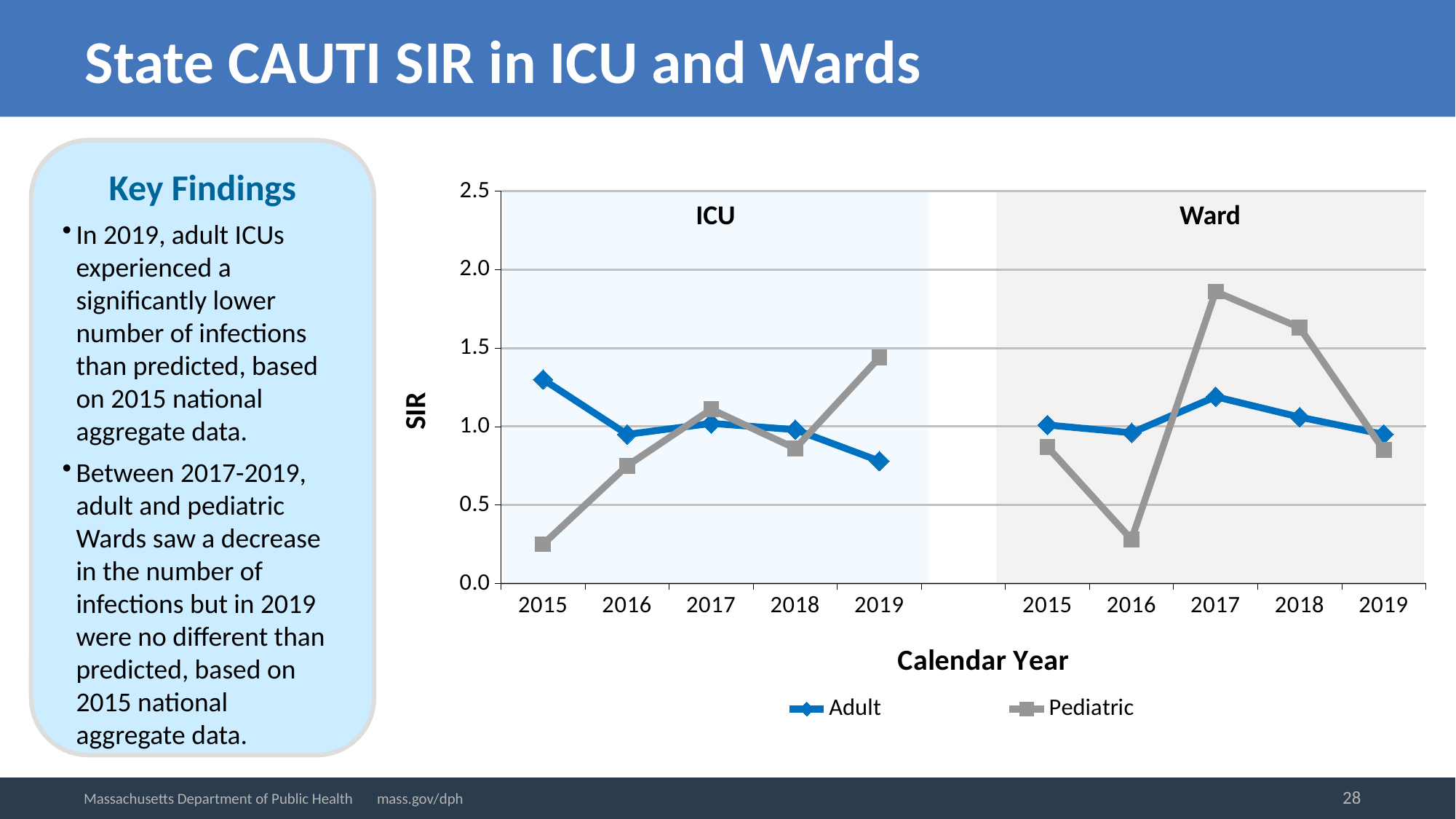
In the Ward panel, in which year is the Pediatric SIR highest? 2017 What are the two series named in the legend? Adult and Pediatric In the ICU panel, in which year is the Pediatric SIR lowest? 2015 What kind of chart is shown on the slide? line chart Is the Pediatric SIR in the ICU panel for 2015 greater or less than 0.5? less How many series does the legend list? 2 Is the Pediatric SIR in the Ward panel for 2017 greater or less than 1.5? greater What are the two panels of the chart labelled? ICU and Ward In the ICU panel for 2015, which series has the higher SIR, Adult or Pediatric? Adult How many calendar years are plotted in the ICU panel? 5 In the ICU panel, in which year is the Adult SIR highest? 2015 In the Ward panel for 2017, which series has the higher SIR, Adult or Pediatric? Pediatric